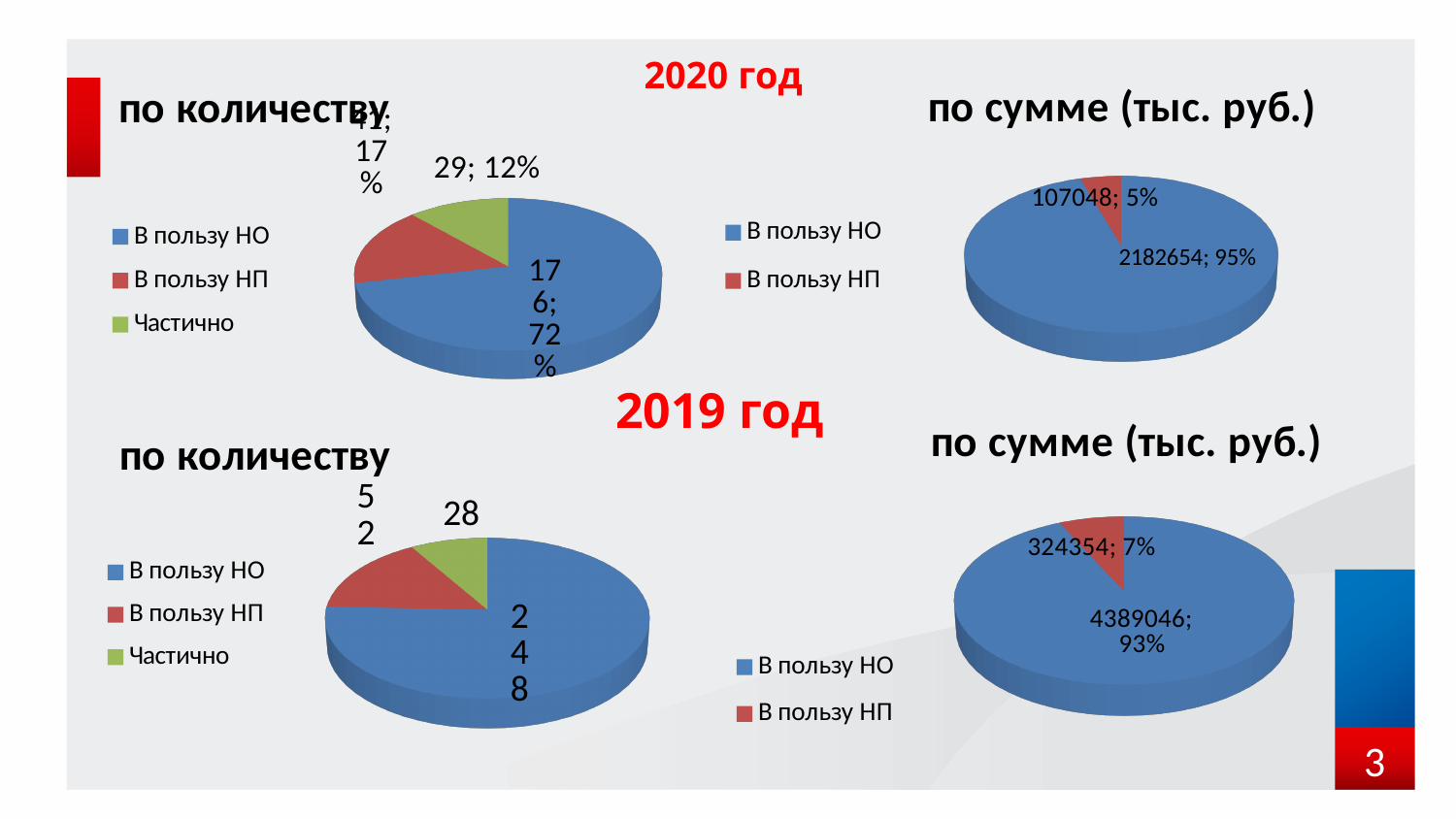
In the 2020 'по сумме (тыс. руб.)' pie chart, what share of the pie does В пользу НО represent? 95% How many categories does the legend of the 2019 'по сумме (тыс. руб.)' chart list? 2 In the 2020 'по сумме (тыс. руб.)' pie chart, what value is shown for В пользу НП? 107048 In the 2019 'по сумме (тыс. руб.)' pie chart, what share of the pie does В пользу НП represent? 7% In the 2020 'по количеству' pie chart, what share of the pie does В пользу НП represent? 17% In the 2020 'по количеству' pie chart, what value is shown for В пользу НО? 176 In the 2019 'по количеству' pie chart, what is the difference between the values for В пользу НО and Частично? 220 In the 2019 'по количеству' pie chart, which category has the largest slice? В пользу НО What type of chart is used for the 2020 'по количеству' data? Pie chart In the 2019 'по количеству' pie chart, what value is shown for В пользу НП? 52 In the 2019 'по сумме (тыс. руб.)' pie chart, what value is shown for В пользу НО? 4389046